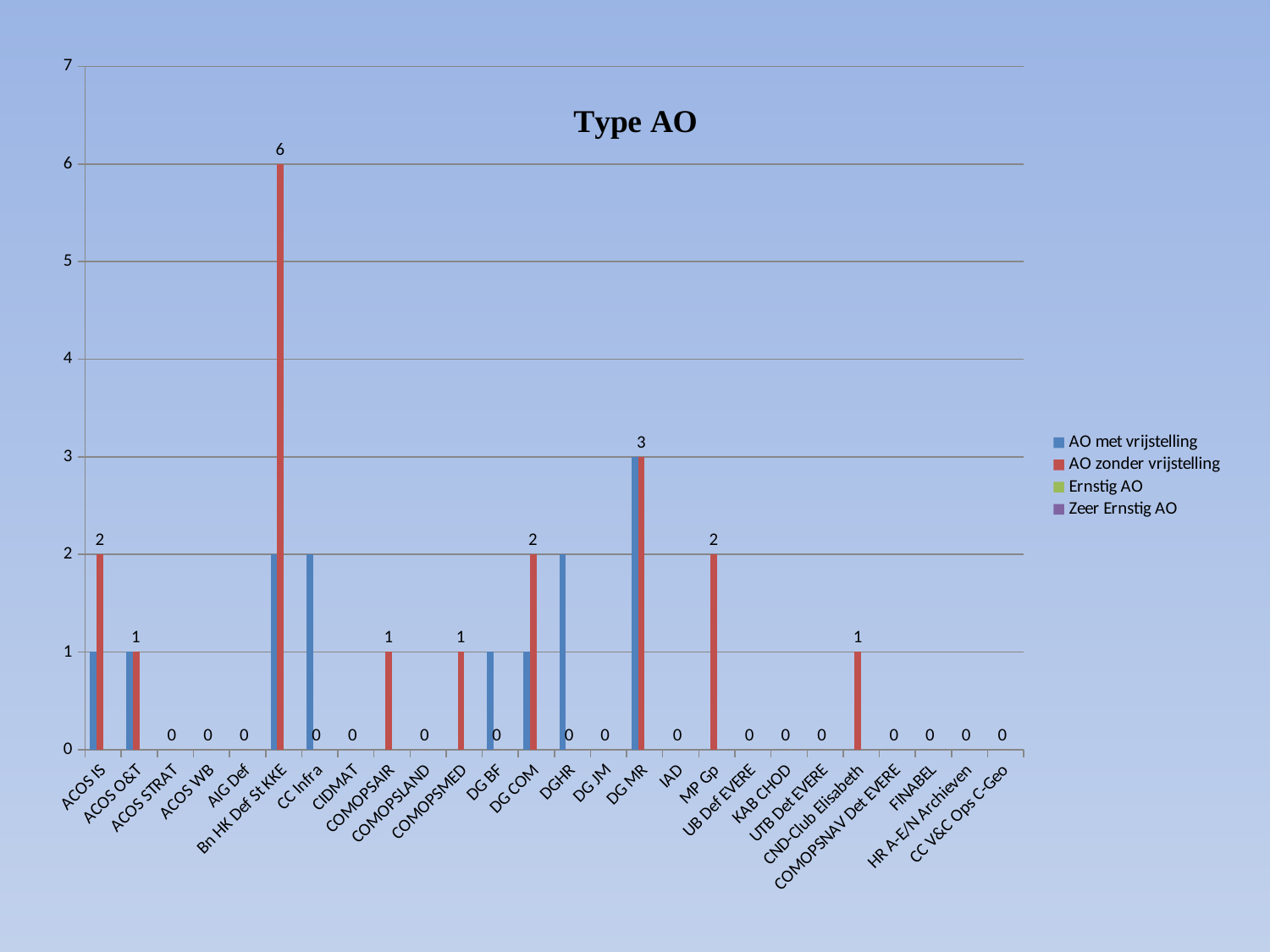
What kind of chart is shown on the slide? bar chart How many categories are shown on the x axis? 26 What is the value of AO zonder vrijstelling for DG MR? 3 What is the value of AO zonder vrijstelling for MP Gp? 2 What is the value of AO zonder vrijstelling for Bn HK Def St KKE? 6 What is the title of the chart? Type AO What is the difference between the AO zonder vrijstelling values for Bn HK Def St KKE and DG MR? 3 Which category has the highest value for AO zonder vrijstelling? Bn HK Def St KKE How many series does the legend list? 4 Which has the larger AO zonder vrijstelling value, ACOS IS or ACOS O&T? ACOS IS What is the value of AO met vrijstelling for DG MR? 3 What is the value of AO zonder vrijstelling for CND-Club Elisabeth? 1